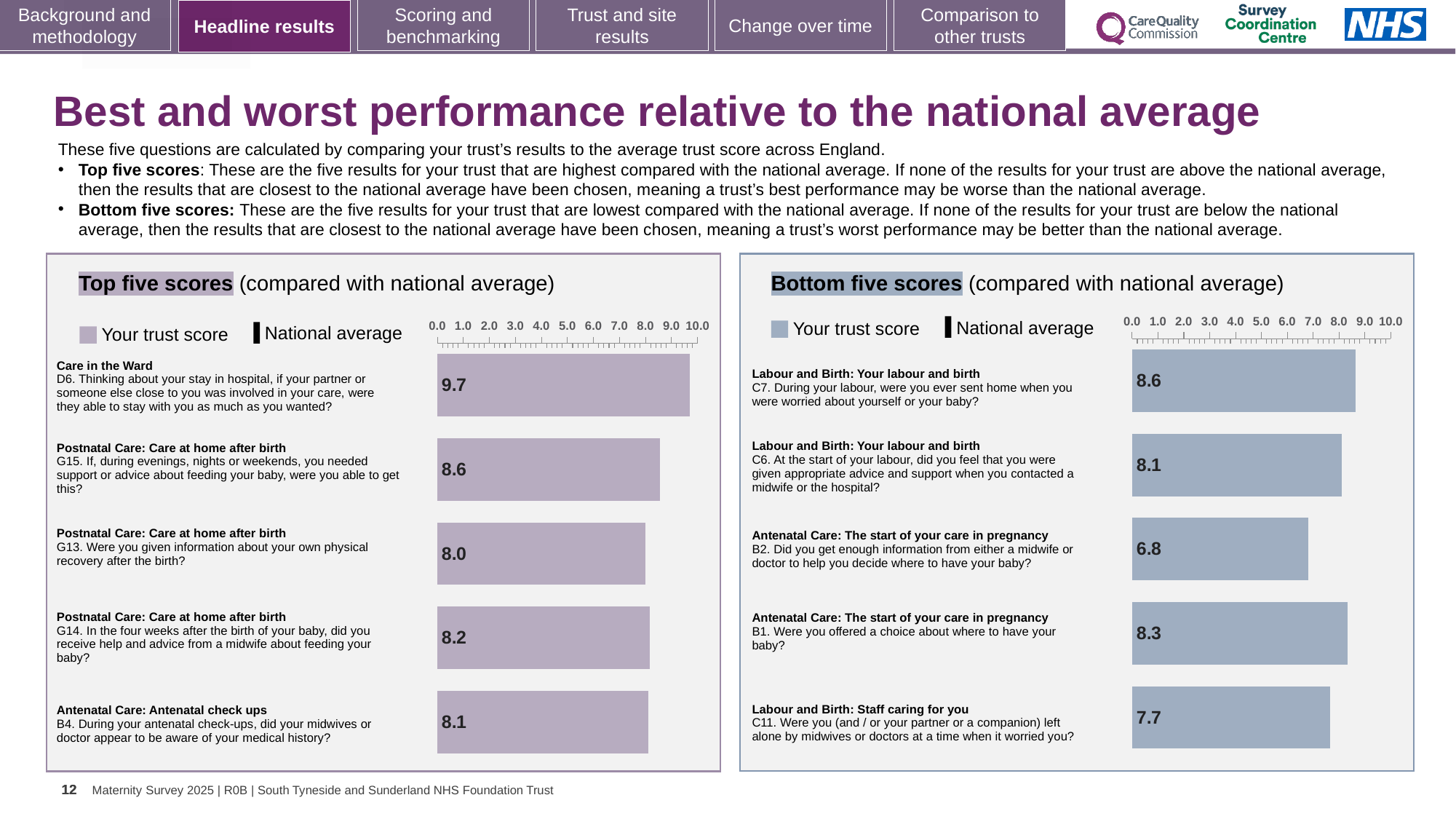
In the Top five scores chart, which question has the highest trust score? D6 (Care in the Ward), 9.7 How many bars are shown in the Top five scores chart? 5 In the Bottom five scores chart, what is the trust score for B2 (enough information to decide where to have your baby)? 6.8 What kind of chart is used in the Bottom five scores panel? Bar chart In the Top five scores chart, which question has the lowest trust score? G13, 8.0 In the Top five scores chart, what is the trust score for D6 (partner able to stay with you as much as you wanted)? 9.7 In the Bottom five scores chart, what is the trust score for C11 (left alone by midwives or doctors when it worried you)? 7.7 In the Bottom five scores chart, what is the difference between the scores for C7 and C11? 0.9 In the Bottom five scores chart, which has the larger trust score, C7 or B1? C7 In the Top five scores chart, is the value for G15 greater or less than 8.0? greater In the Bottom five scores chart, which question has the lowest trust score? B2, 6.8 In the Top five scores chart, what is the difference between the scores for D6 and G13? 1.7